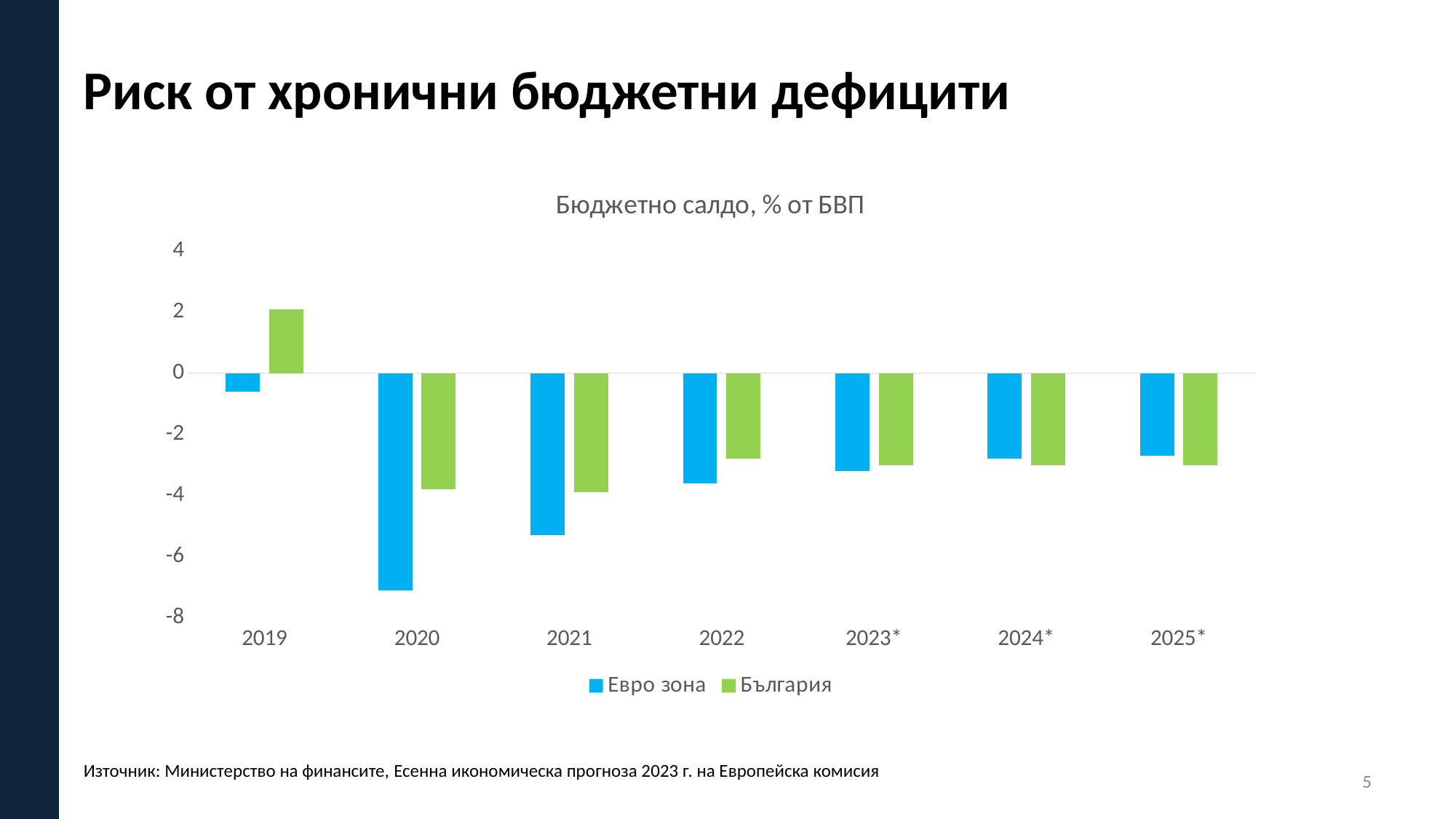
Is the value for Евро зона in 2020 greater or less than -6? less Which series and year has the highest value in the chart? България, 2019 How many years are shown on the x axis? 7 Is the value for Евро зона in 2021 greater or less than -4? less Is the value for България in 2019 greater or less than 0? greater What kind of chart is shown on the slide? bar chart How many series does the legend list? 2 What is the title of the chart? Бюджетно салдо, % от БВП Which series and year has the lowest value in the chart? Евро зона, 2020 Does the value for Евро зона rise or fall from 2020 to 2025*? rise In 2020, which is larger, the value for Евро зона or for България? България